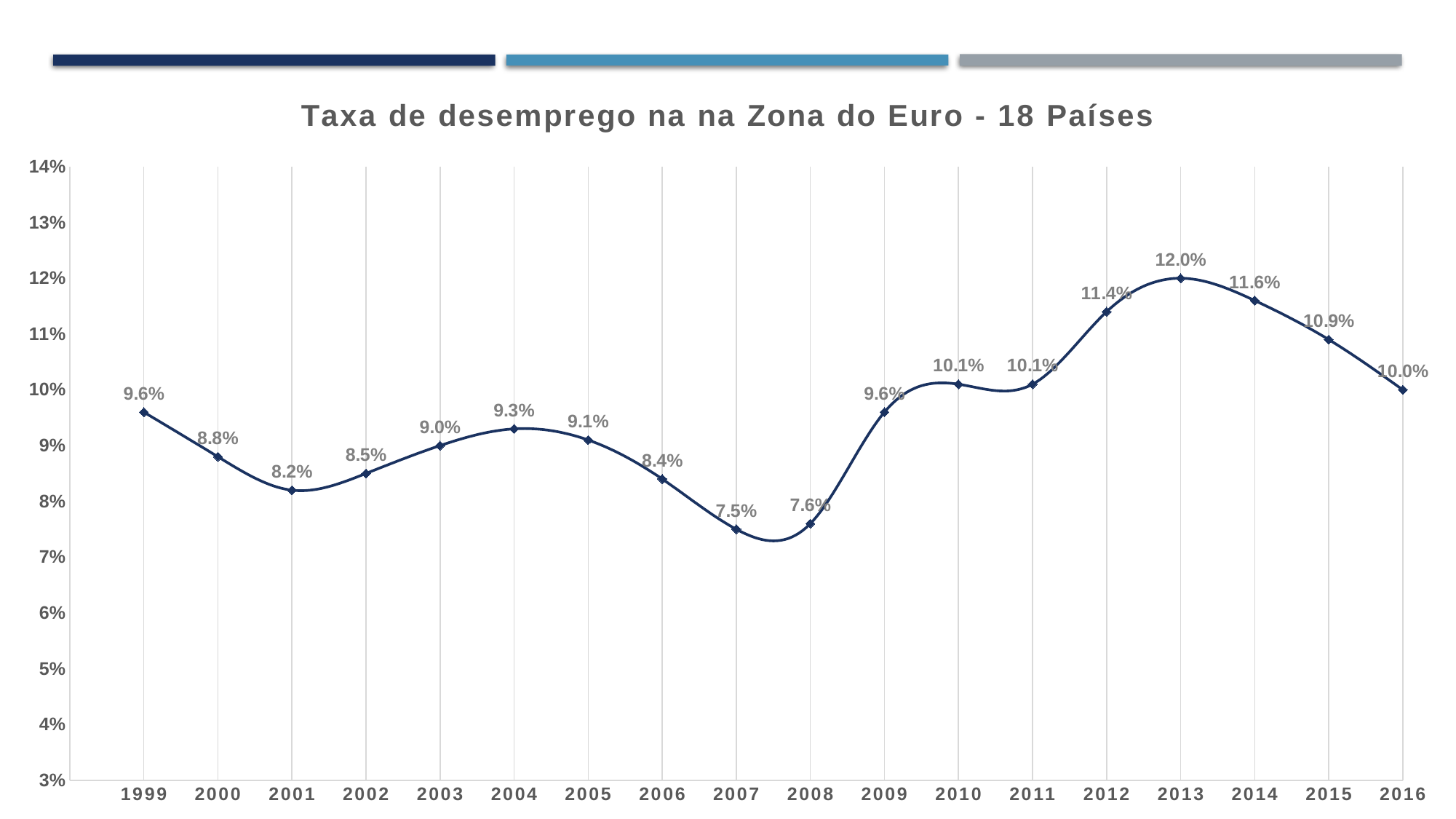
Is the value for 2012 greater or less than 11%? greater What is the unemployment rate shown for 2013? 12.0% What kind of chart is shown on the slide? Line chart What is the value plotted for 2007? 7.5% What is the difference between the values for 2013 and 2007? 4.5% Which year has the larger value, 2004 or 2006? 2004 How many years are plotted on the x axis? 18 What is the value shown for 1999? 9.6% What is the title of the chart? Taxa de desemprego na na Zona do Euro - 18 Países Which year has the highest unemployment rate on the chart? 2013 Which year has the lowest unemployment rate on the chart? 2007 Do the values rise or fall from 2013 to 2016? Fall